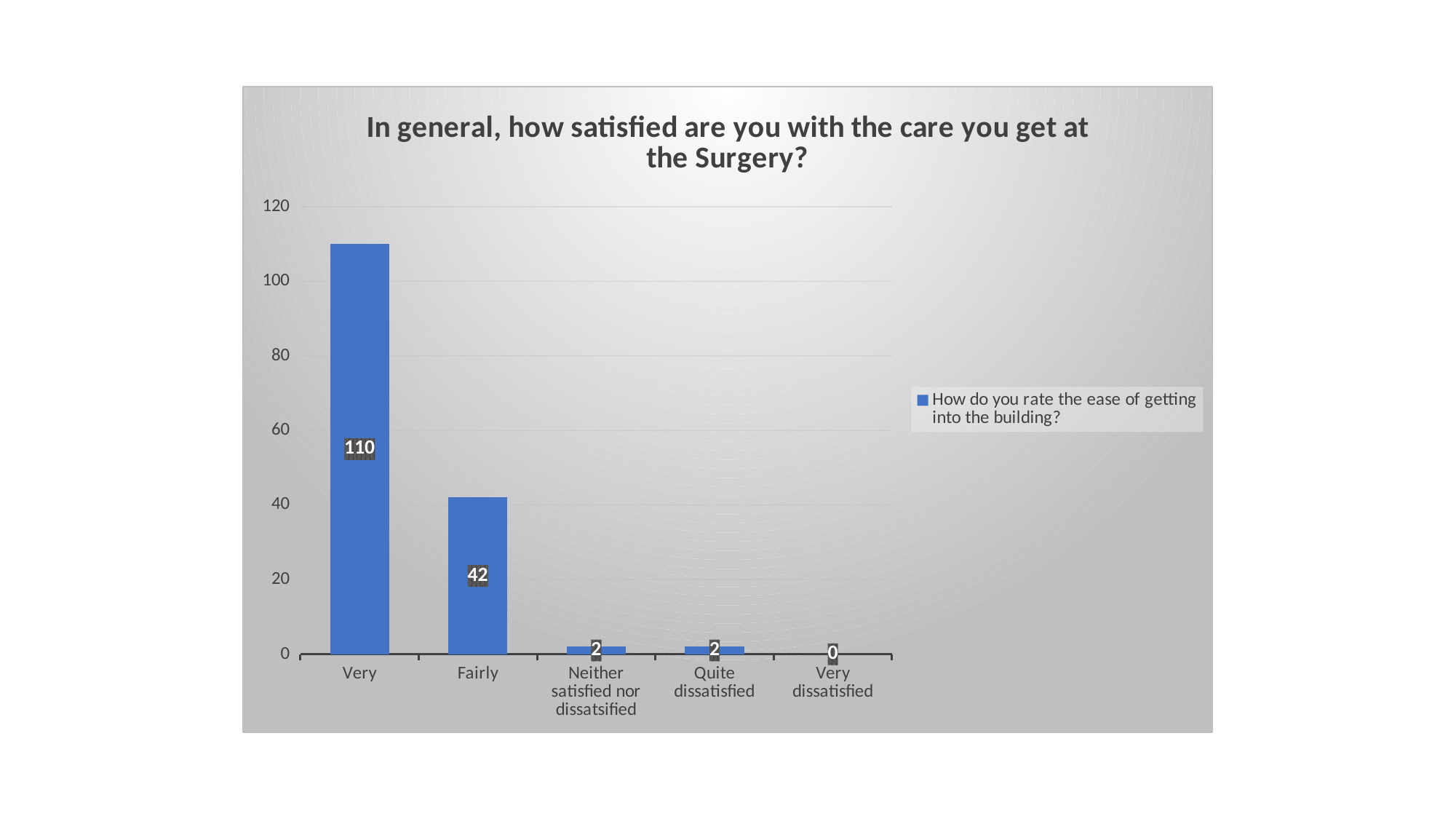
Which category has the lowest value? Very dissatisfied Which category has the highest value? Very What is the difference between the values for "Very" and "Fairly"? 68 Is the value for "Very" greater or less than 100? greater What is the value for "Very dissatisfied"? 0 What is the value for the "Very" category? 110 Which is larger, the value for "Fairly" or the value for "Neither satisfied nor dissatsified"? Fairly How many categories are shown on the x axis? 5 What kind of chart is shown on the slide? Bar chart What is the title of the chart? In general, how satisfied are you with the care you get at the Surgery? What is the value for "Quite dissatisfied"? 2 What is the value for the "Fairly" category? 42